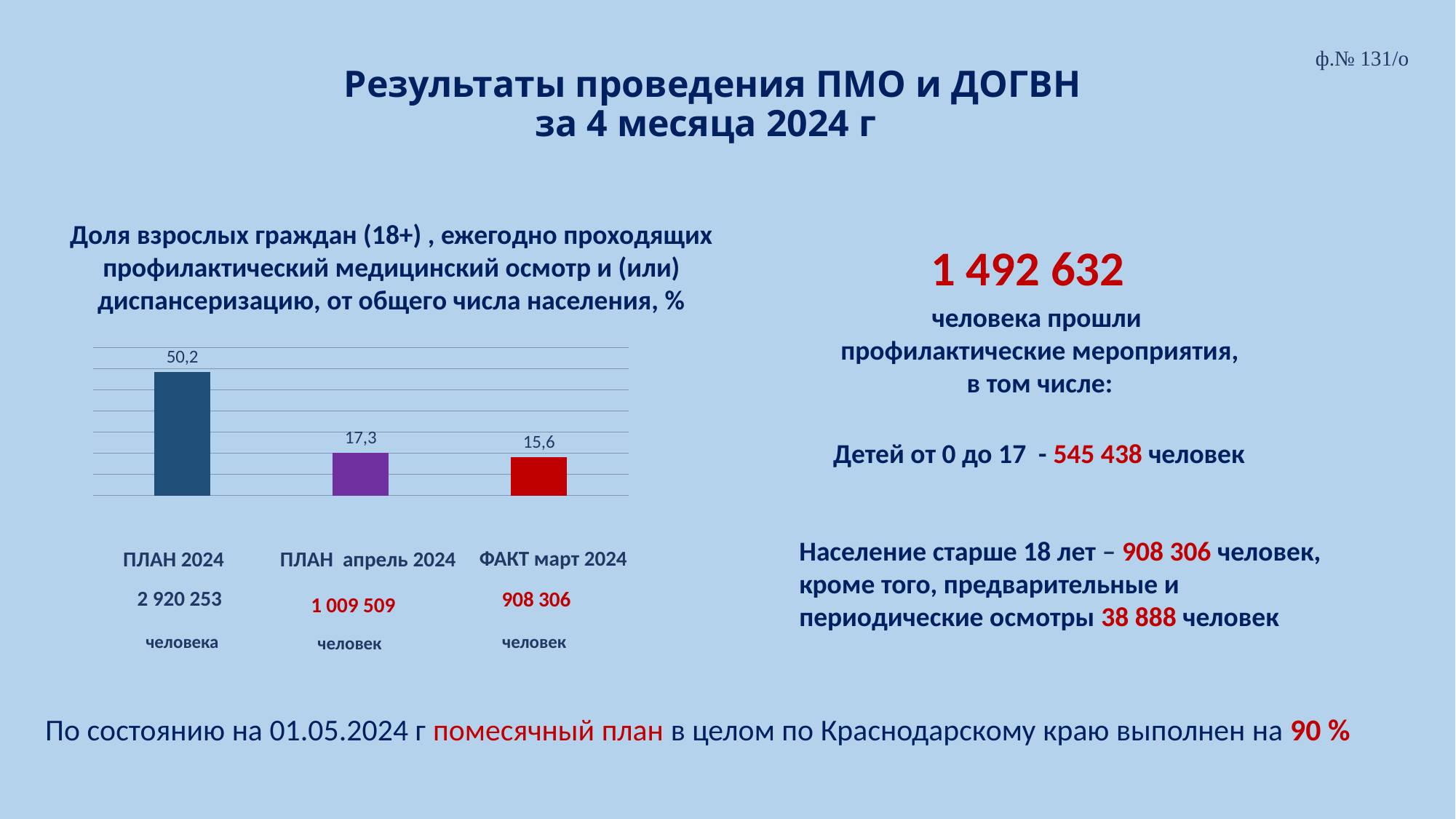
Do the values rise or fall from left to right across the bars? Fall What is the value for ФАКТ март 2024 in the bar chart? 15,6 What is the difference between the values for ПЛАН апрель 2024 and ФАКТ март 2024? 1,7 What kind of chart is shown on the slide? Bar chart Which category has the lowest value in the bar chart? ФАКТ март 2024 What colour is the bar for ПЛАН апрель 2024? Purple How many bars are shown in the bar chart? 3 Which is larger: the value for ПЛАН 2024 or the value for ФАКТ март 2024? ПЛАН 2024 What is the difference between the values for ПЛАН 2024 and ПЛАН апрель 2024? 32,9 What is the value for ПЛАН апрель 2024 in the bar chart? 17,3 What is the value for ПЛАН 2024 in the bar chart? 50,2 Which category has the highest value in the bar chart? ПЛАН 2024